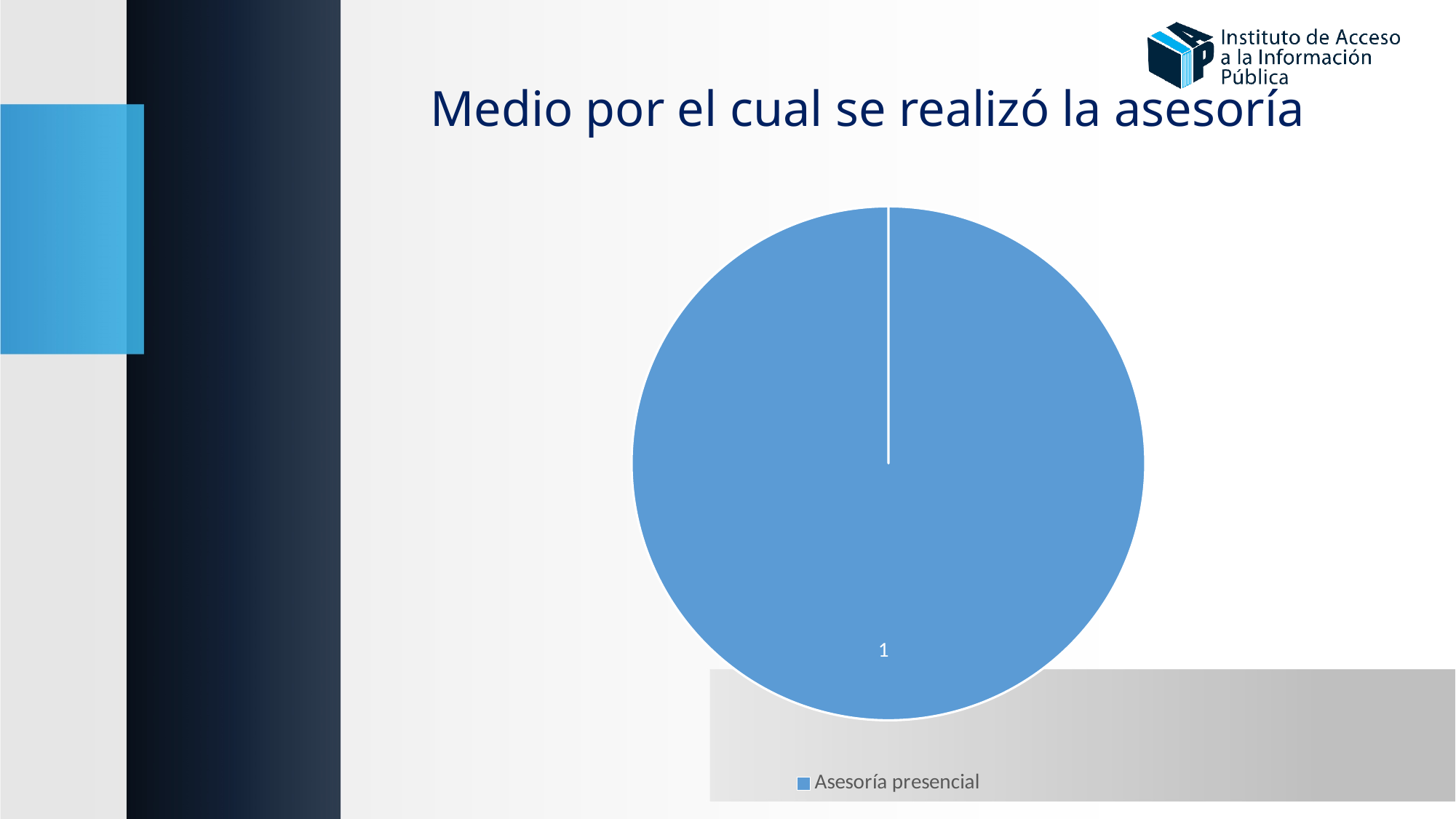
What kind of chart is shown on the slide? pie chart What is the value shown for Asesoría presencial? 1 What is the title of the chart? Medio por el cual se realizó la asesoría What share of the pie does Asesoría presencial represent? 100% How many slices does the pie chart have? 1 How many entries does the legend list? 1 What category does the legend list? Asesoría presencial